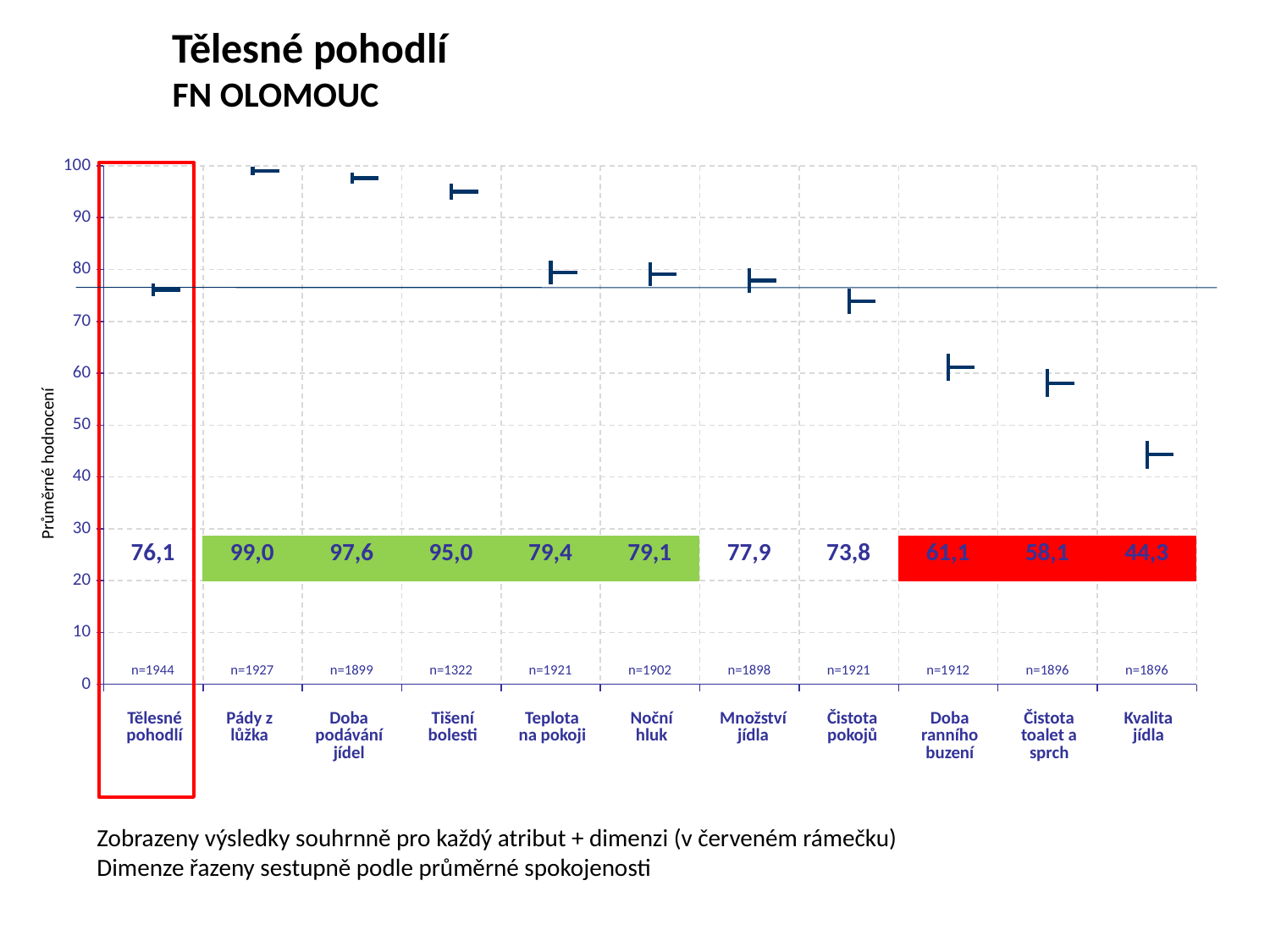
What is the sample size (n) shown for Tišení bolesti? n=1322 Which attribute has the highest value? Pády z lůžka What is the difference between the values for Pády z lůžka and Kvalita jídla? 54,7 What is the value shown for the dimension Tělesné pohodlí (in the red frame)? 76,1 Which has a higher value, Teplota na pokoji or Noční hluk? Teplota na pokoji Do the attribute values rise or fall from left to right after Tělesné pohodlí? fall Which attribute has the lowest value? Kvalita jídla How many categories are shown on the x axis? 11 What is the value shown for Pády z lůžka? 99,0 What is the label of the y axis? Průměrné hodnocení Is the value for Doba ranního buzení greater or less than 70? less What is the value shown for Kvalita jídla? 44,3